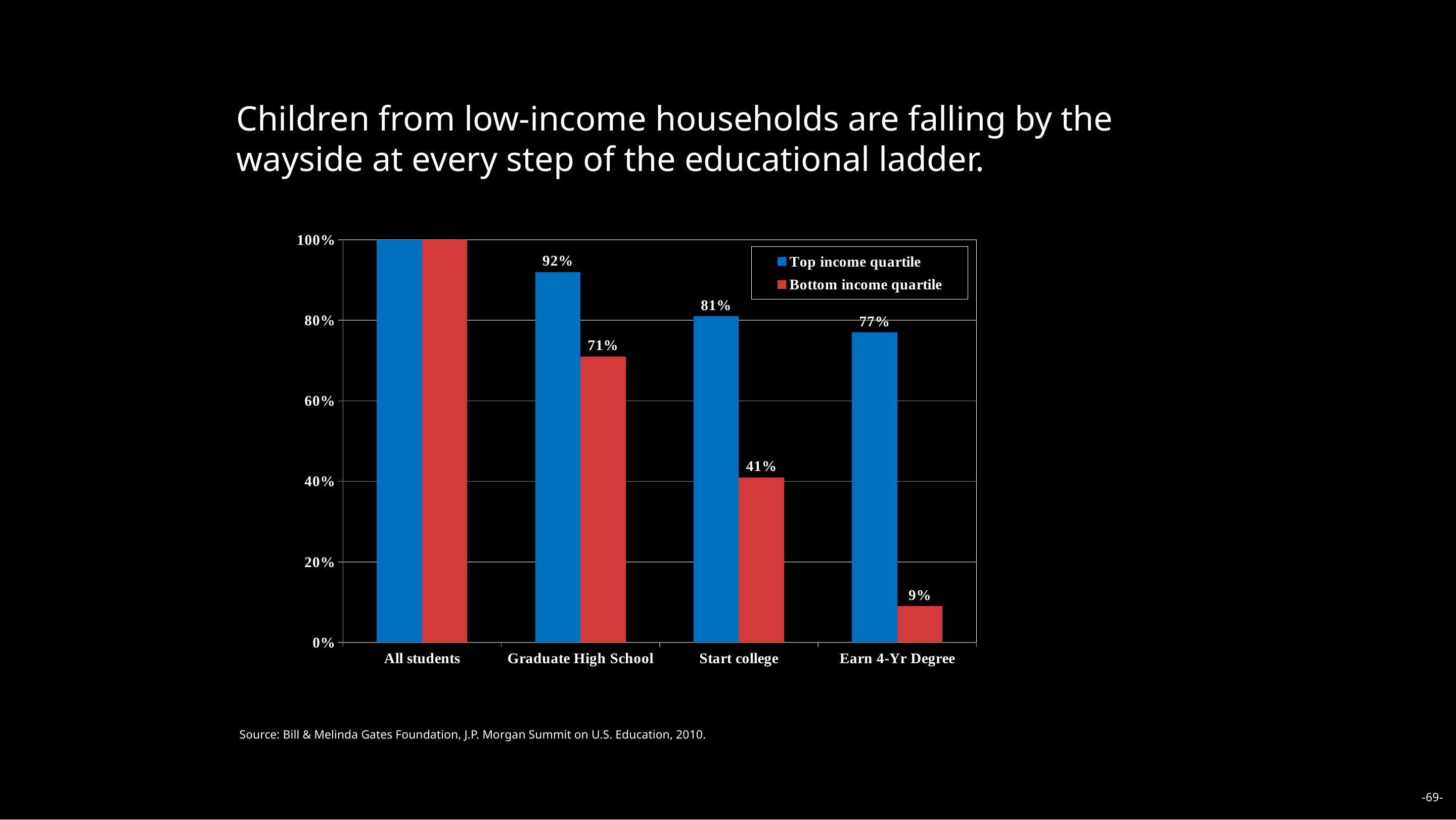
How many series does the legend list? 2 Do the Bottom income quartile values rise or fall from All students to Earn 4-Yr Degree? Fall What is the value for Top income quartile at Earn 4-Yr Degree? 77% What is the value for Top income quartile at Graduate High School? 92% What is the value for Bottom income quartile at Start college? 41% What is the difference between Top income quartile and Bottom income quartile at Start college? 40% What is the difference between Top income quartile and Bottom income quartile at Earn 4-Yr Degree? 68% Which category has the lowest value for Bottom income quartile? Earn 4-Yr Degree Which is larger at Graduate High School: Top income quartile or Bottom income quartile? Top income quartile What kind of chart is shown on the slide? Bar chart How many categories are shown on the x axis? 4 What is the value for Bottom income quartile at Earn 4-Yr Degree? 9%